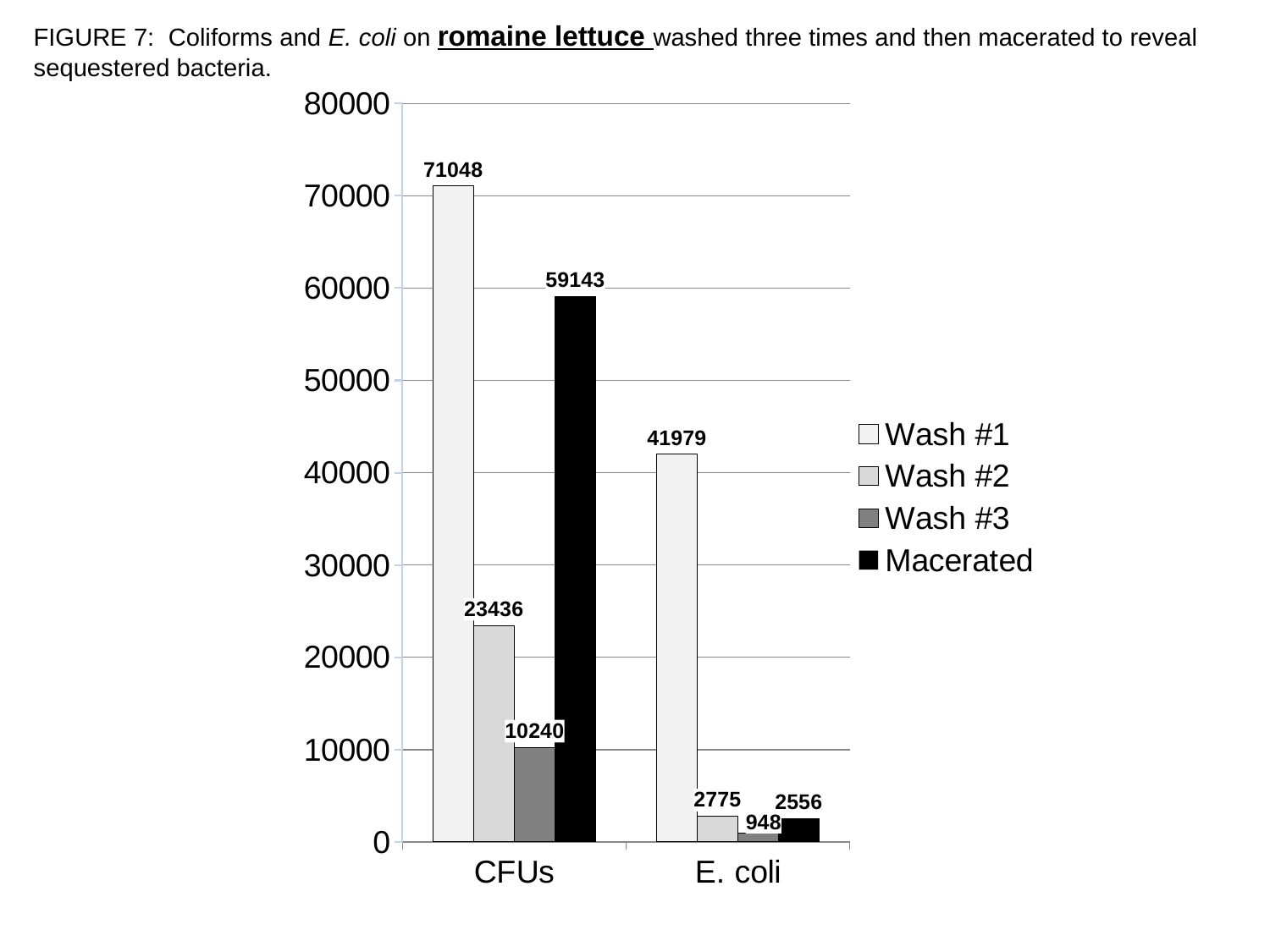
How many series does the legend list? 4 Which is larger in the E. coli category, Wash #2 or Macerated? Wash #2 What is the difference between Wash #1 and Wash #2 in the CFUs category? 47612 Is the value for Macerated in the CFUs category greater or less than 50000? greater What kind of chart is shown on the slide? bar chart What is the value for Wash #1 in the CFUs category? 71048 Which series has the lowest value in the E. coli category? Wash #3 How many categories are shown on the x axis? 2 What is the value for Macerated in the E. coli category? 2556 Which series has the highest value in the CFUs category? Wash #1 Which series is shown in black in the legend? Macerated What is the value for Wash #3 in the E. coli category? 948